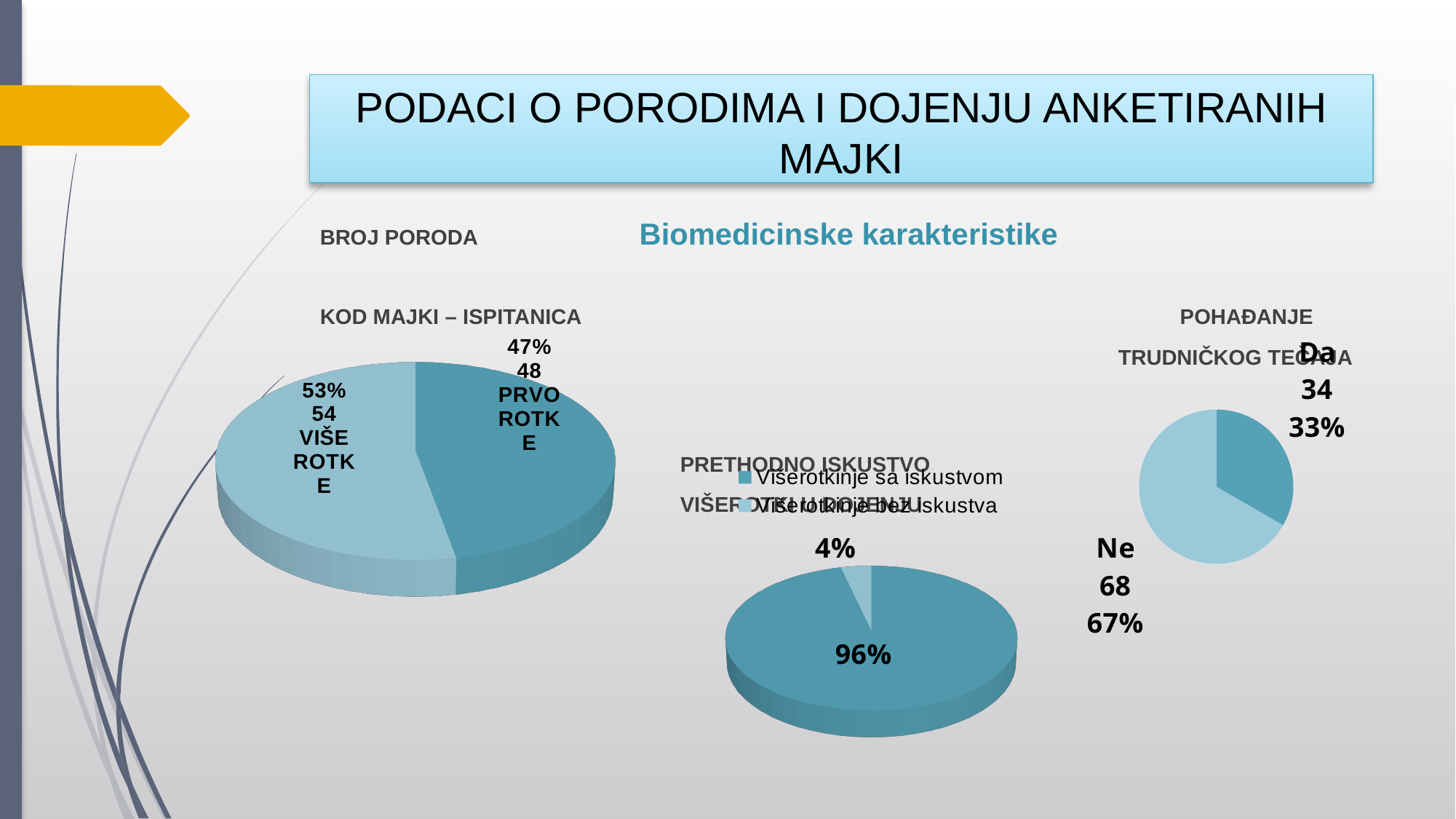
In the right chart (POHAĐANJE TRUDNIČKOG TEČAJA), which category has the smaller share? Da In the middle chart (PRETHODNO ISKUSTVO VIŠEROTKI U DOJENJU), what percentage is shown for the smaller slice? 4% In the right chart (POHAĐANJE TRUDNIČKOG TEČAJA), what percentage is shown for Da? 33% What type of chart is used for BROJ PORODA KOD MAJKI – ISPITANICA? Pie chart In the left chart (BROJ PORODA KOD MAJKI – ISPITANICA), what is the difference in count between VIŠEROTKE and PRVOROTKE? 6 How many entries does the legend of the middle chart (PRETHODNO ISKUSTVO VIŠEROTKI U DOJENJU) list? 2 In the right chart (POHAĐANJE TRUDNIČKOG TEČAJA), what is the total of the Da and Ne counts? 102 In the left chart (BROJ PORODA KOD MAJKI – ISPITANICA), what percentage is labelled for VIŠEROTKE? 53% In the middle chart (PRETHODNO ISKUSTVO VIŠEROTKI U DOJENJU), what percentage is shown for the larger slice? 96% In the right chart (POHAĐANJE TRUDNIČKOG TEČAJA), what count is shown for Ne? 68 In the left chart (BROJ PORODA KOD MAJKI – ISPITANICA), what count is shown for PRVOROTKE? 48 In the left chart (BROJ PORODA KOD MAJKI – ISPITANICA), which category has the larger share? VIŠEROTKE